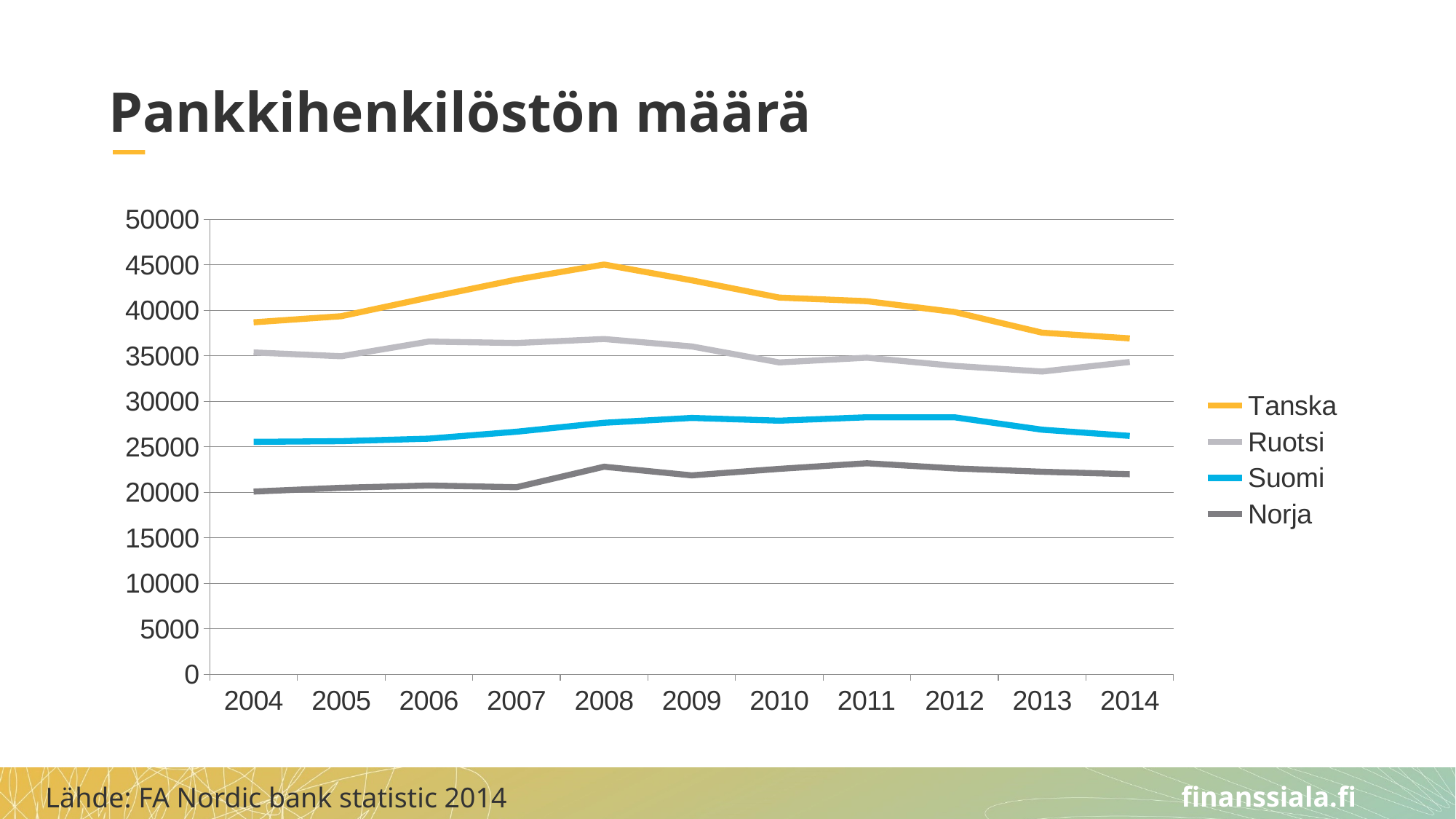
In which year does the Tanska series reach its highest value? 2008 Does the Tanska series rise or fall from 2008 to 2014? fall Which is larger in 2008, the value for Ruotsi or the value for Suomi? Ruotsi Is the value for Suomi in 2014 greater or less than 30000? less How many years are shown along the x axis? 11 Is the value for Tanska in 2008 greater or less than 40000? greater Which series has the lowest value in 2014? Norja Is the value for Norja in 2004 greater or less than 25000? less How many series does the legend list? 4 What is the title of the chart? Pankkihenkilöstön määrä What kind of chart is shown on the slide? line chart Which series has the highest value in 2008? Tanska